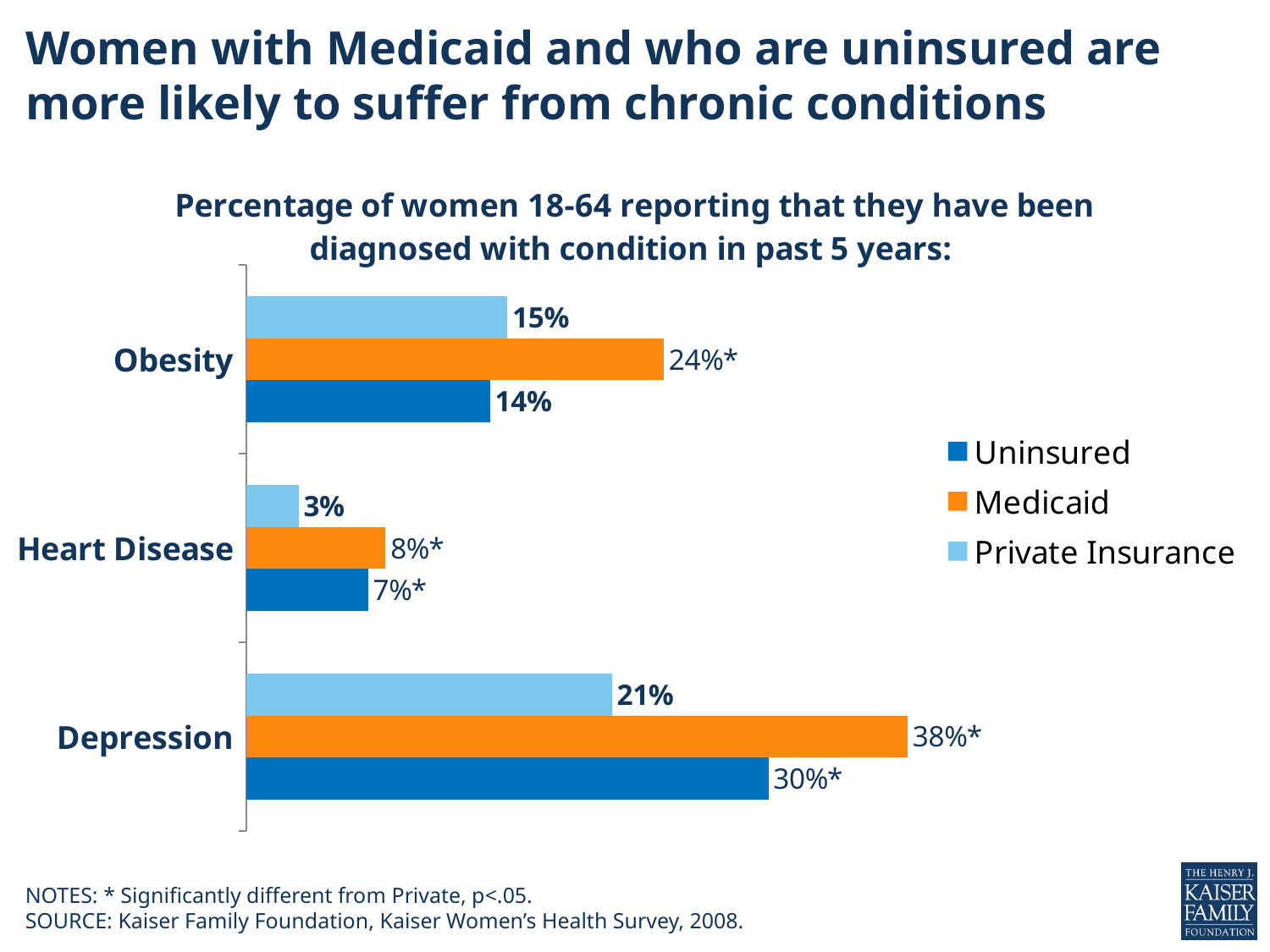
How many series does the legend list? 3 Which is larger for obesity: the private insurance percentage or the uninsured percentage? Private Insurance What percentage of uninsured women reported being diagnosed with heart disease? 7% What percentage of women with Medicaid reported being diagnosed with obesity? 24% What is the difference between the Medicaid and uninsured percentages for depression? 8% What kind of chart is shown on the slide? Bar chart What is the difference between the Medicaid and private insurance percentages for obesity? 9% Which insurance group has the lowest percentage reporting heart disease? Private Insurance Which insurance group has the highest percentage reporting depression? Medicaid How many conditions are shown on the chart? 3 Which colour represents the Medicaid series in the chart? Orange What percentage of women with private insurance reported being diagnosed with depression? 21%